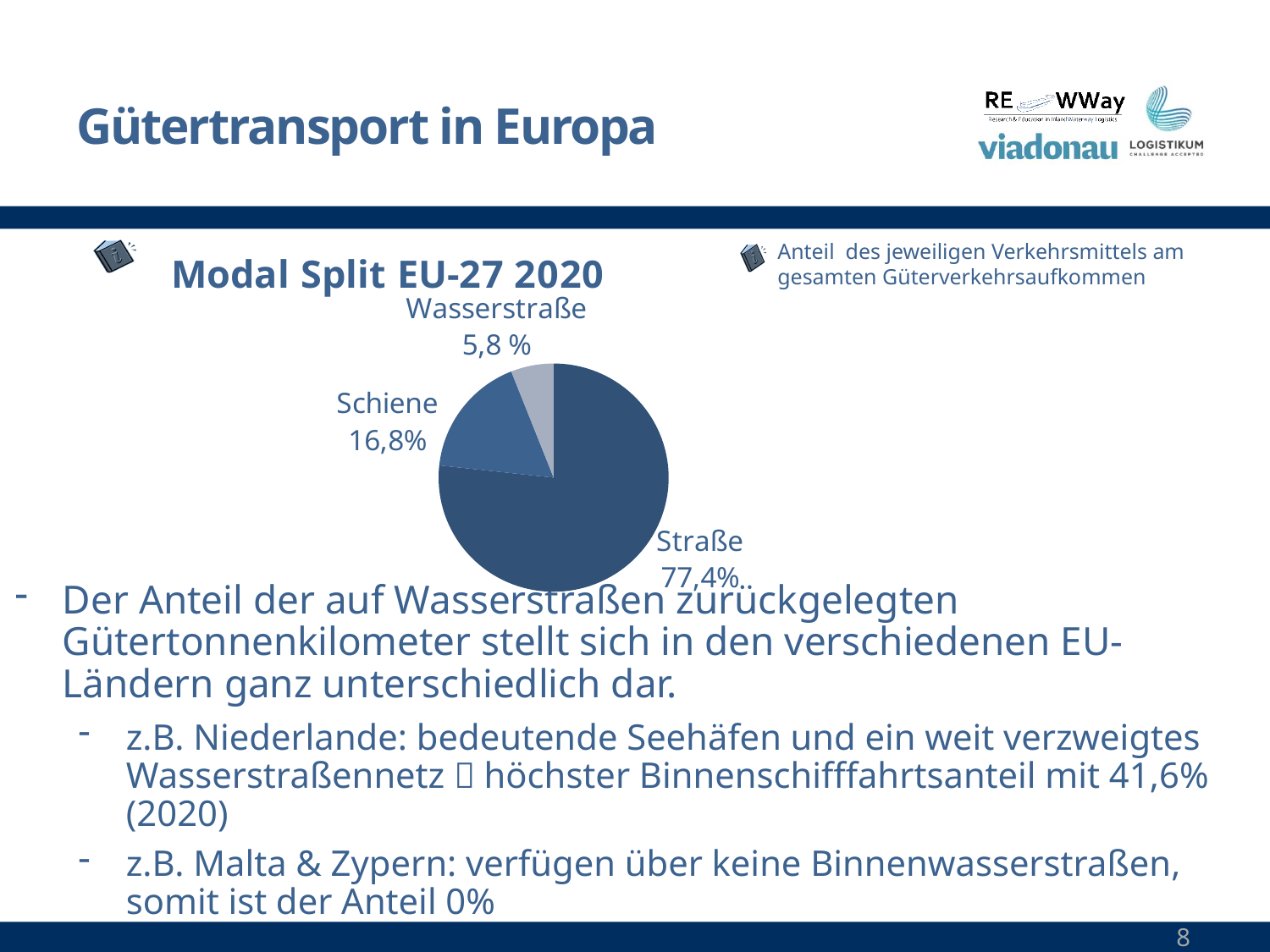
What share of the pie chart does Straße account for? 77,4% Which slice of the pie chart is shown in the lightest grey colour? Wasserstraße What share of the pie chart does Wasserstraße account for? 5,8 % What is the difference in percentage points between the Schiene and Wasserstraße slices? 11,0 Which mode of transport has the smallest slice in the pie chart? Wasserstraße What is the title of the chart? Modal Split EU-27 2020 Which slice is larger, Schiene or Wasserstraße? Schiene What share of the pie chart does Schiene account for? 16,8% What is the difference in percentage points between the Straße and Schiene slices? 60,6 How many slices does the pie chart have? 3 Which mode of transport has the largest slice in the pie chart? Straße What kind of chart is shown on the slide? Pie chart